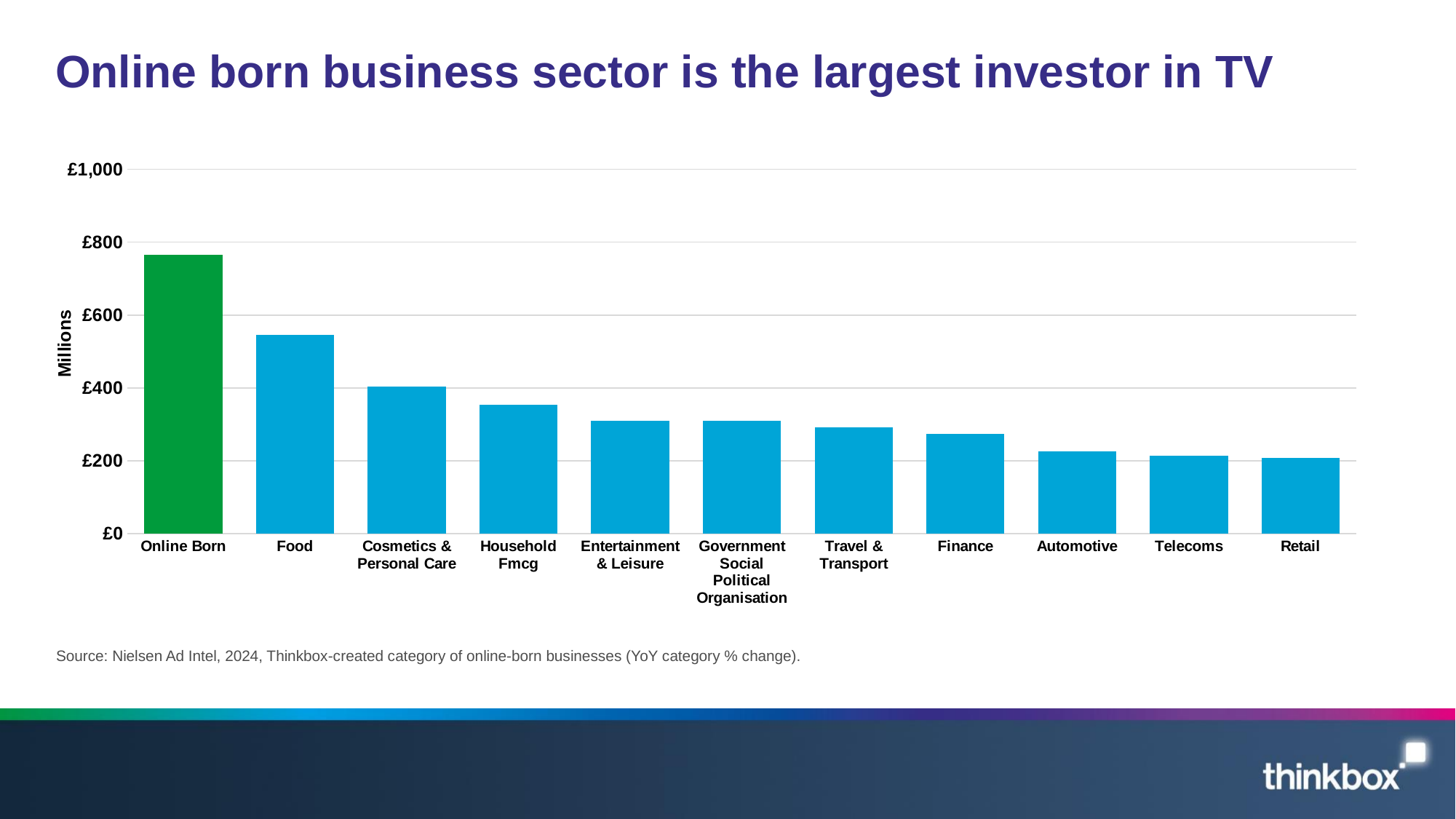
How many sectors are shown on the x axis of the chart? 11 Is the value for Household Fmcg greater or less than £400? less Do the bar values rise or fall moving from left to right along the x axis? fall Which is larger, the value for Online Born or the value for Food? Online Born Which sector has the highest TV investment in the chart? Online Born Which is larger, the value for Food or the value for Cosmetics & Personal Care? Food What kind of chart is shown on the slide? bar chart What colour is the Online Born bar? green Is the value for Finance greater or less than £400? less Is the value for Online Born greater or less than £600? greater